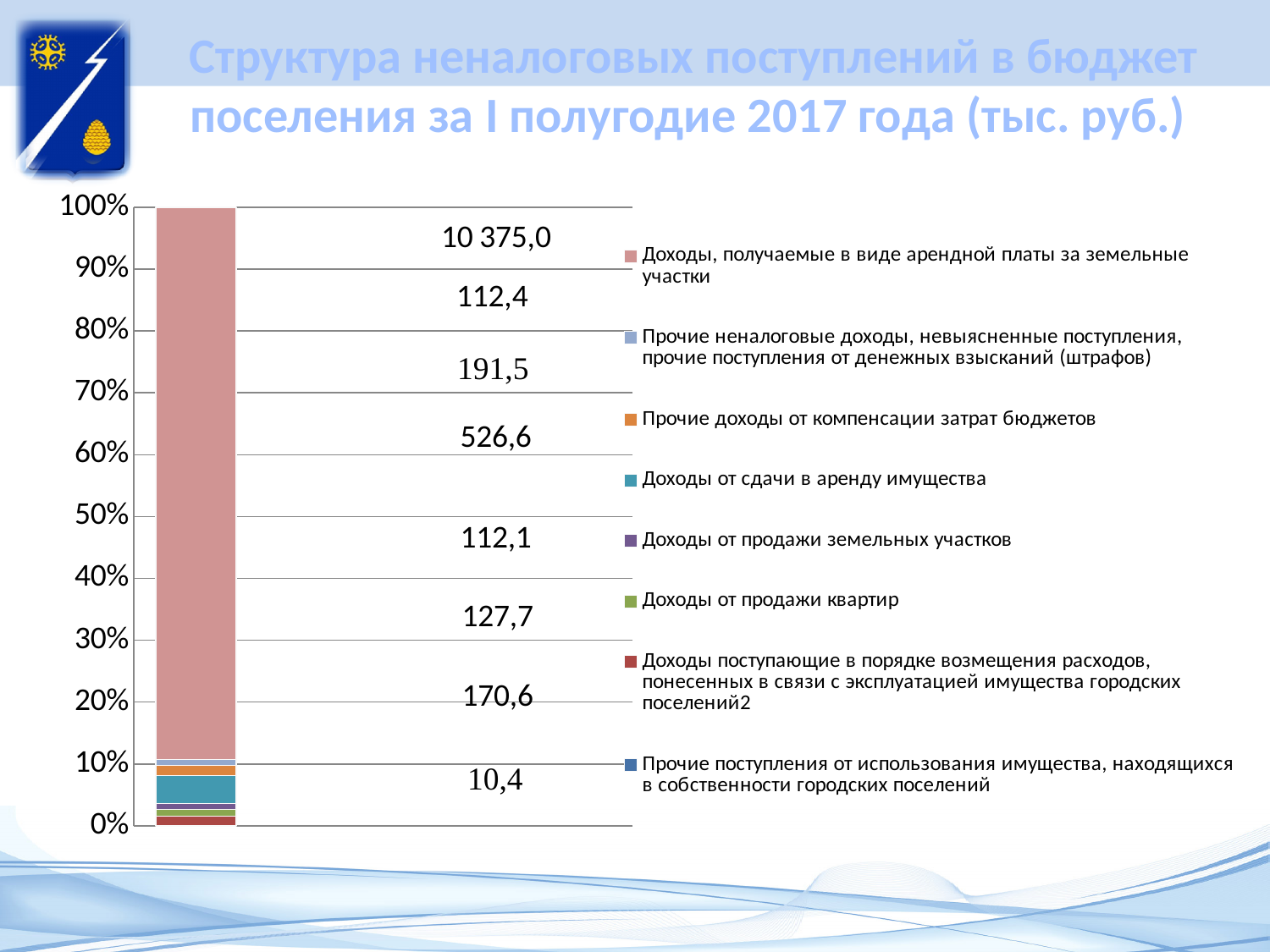
Which series has the highest value in the bar? Доходы, получаемые в виде арендной платы за земельные участки Which is larger: the value for 'Доходы от продажи квартир' or the value for 'Доходы от продажи земельных участков'? Доходы от продажи квартир What is the value for 'Прочие доходы от компенсации затрат бюджетов'? 191,5 What is the value for 'Доходы, получаемые в виде арендной платы за земельные участки'? 10 375,0 What is the total of all segments in the stacked bar? 11 626,3 Which series has the lowest value in the bar? Прочие поступления от использования имущества, находящихся в собственности городских поселений What is the value for 'Доходы от сдачи в аренду имущества'? 526,6 What is the value for 'Прочие поступления от использования имущества, находящихся в собственности городских поселений'? 10,4 What is the difference between the values for 'Доходы от сдачи в аренду имущества' and 'Прочие доходы от компенсации затрат бюджетов'? 335,1 What kind of chart is shown on the slide? stacked bar chart What is the value for 'Доходы от продажи квартир'? 127,7 How many series does the legend list? 8